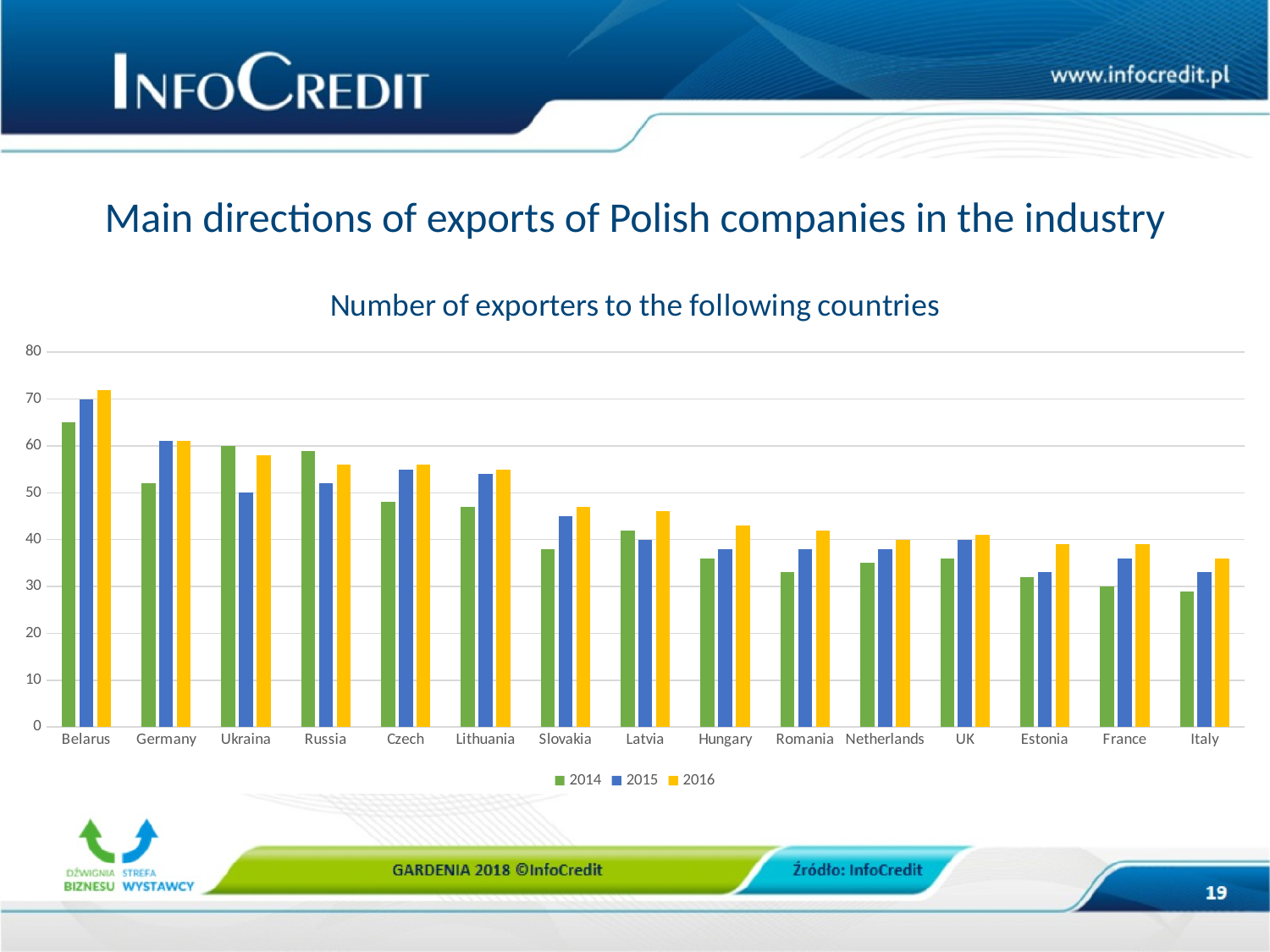
Is the value for Belarus in 2014 greater or less than 60? greater Which country has the highest number of exporters in 2016? Belarus How many countries are shown on the x axis of the chart? 15 Is the value for Latvia in 2016 greater or less than 40? greater How many series does the legend list? 3 For Germany, which year has the larger number of exporters, 2014 or 2015? 2015 For Ukraina, which year has the larger number of exporters, 2014 or 2015? 2014 What kind of chart is shown on the slide? bar chart Is the value for Czech in 2014 greater or less than 50? less What is the title of the chart? Number of exporters to the following countries